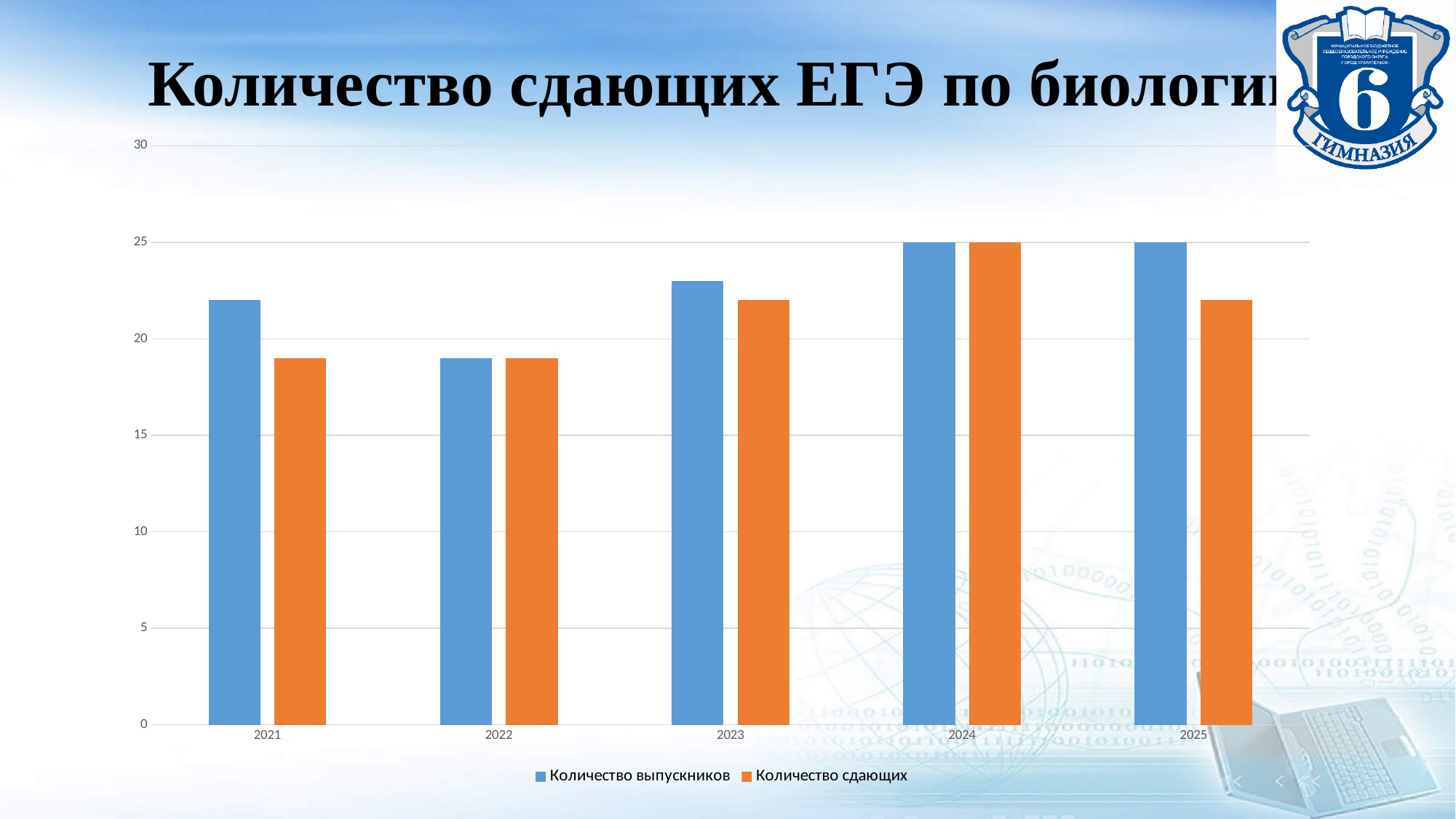
In which year is Количество выпускников the lowest? 2022 What is the value of Количество сдающих for 2024? 25 For 2025, which is larger: Количество выпускников or Количество сдающих? Количество выпускников Is the value of Количество выпускников for 2022 greater or less than 20? less Is the value of Количество выпускников for 2021 greater or less than 20? greater How many years are shown on the x axis? 5 How many series does the legend list? 2 What kind of chart is shown on the slide? bar chart What is the value of Количество выпускников for 2025? 25 In which year is Количество сдающих the highest? 2024 Is the value of Количество сдающих for 2021 greater or less than 20? less What is the value of Количество выпускников for 2024? 25